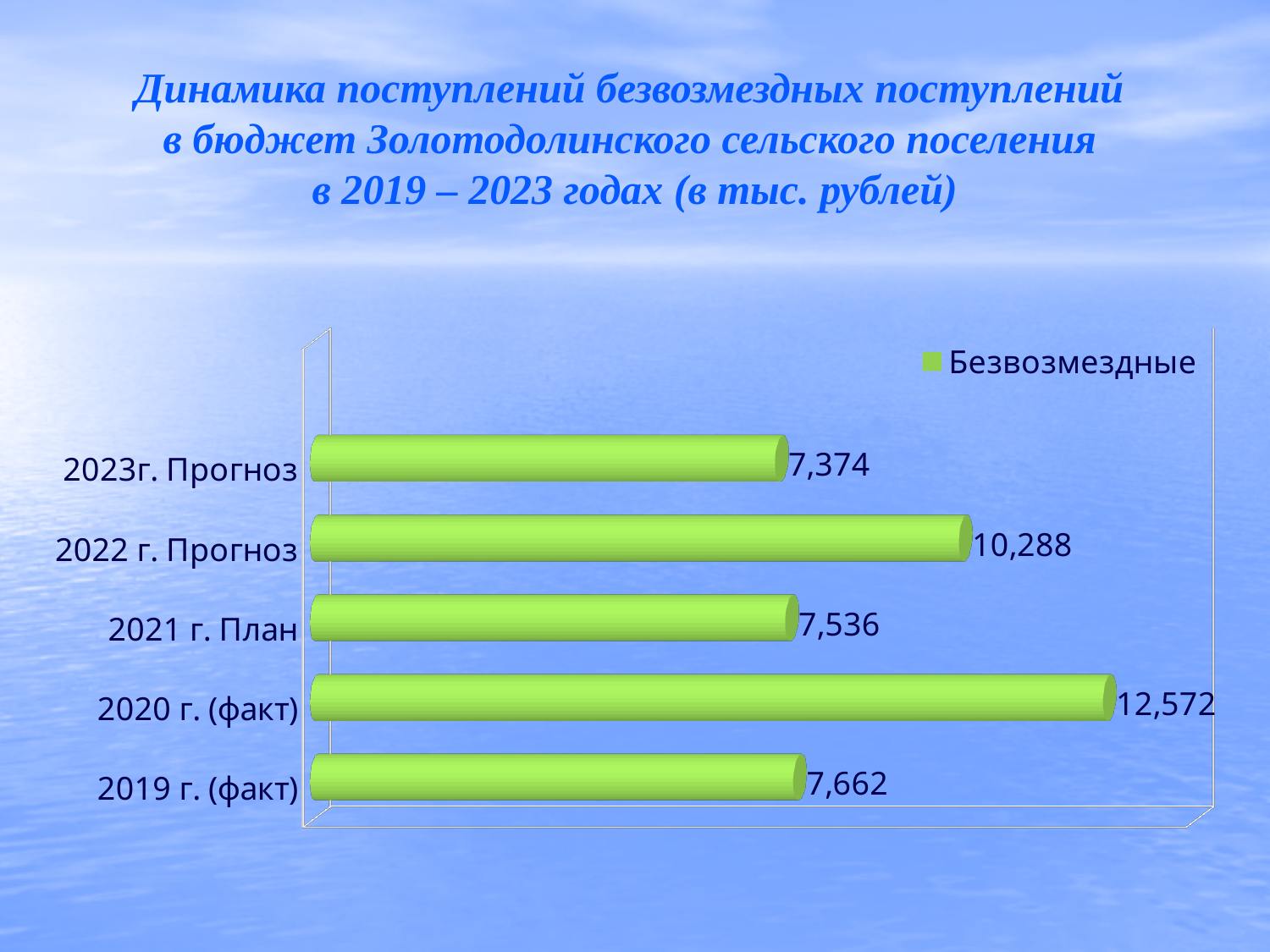
What is the value for 2022 г. Прогноз? 10,288 What is the difference between the values for 2022 г. Прогноз and 2021 г. План? 2,752 What is the value for 2020 г. (факт)? 12,572 Which category has the highest value? 2020 г. (факт) What kind of chart is shown on the slide? Bar chart Which category has the lowest value? 2023г. Прогноз What is the value for 2023г. Прогноз? 7,374 Which is larger, the value for 2019 г. (факт) or the value for 2021 г. План? 2019 г. (факт) How many series does the legend list? 1 What is the value for 2021 г. План? 7,536 What is the difference between the values for 2020 г. (факт) and 2019 г. (факт)? 4,910 How many categories are shown in the chart? 5